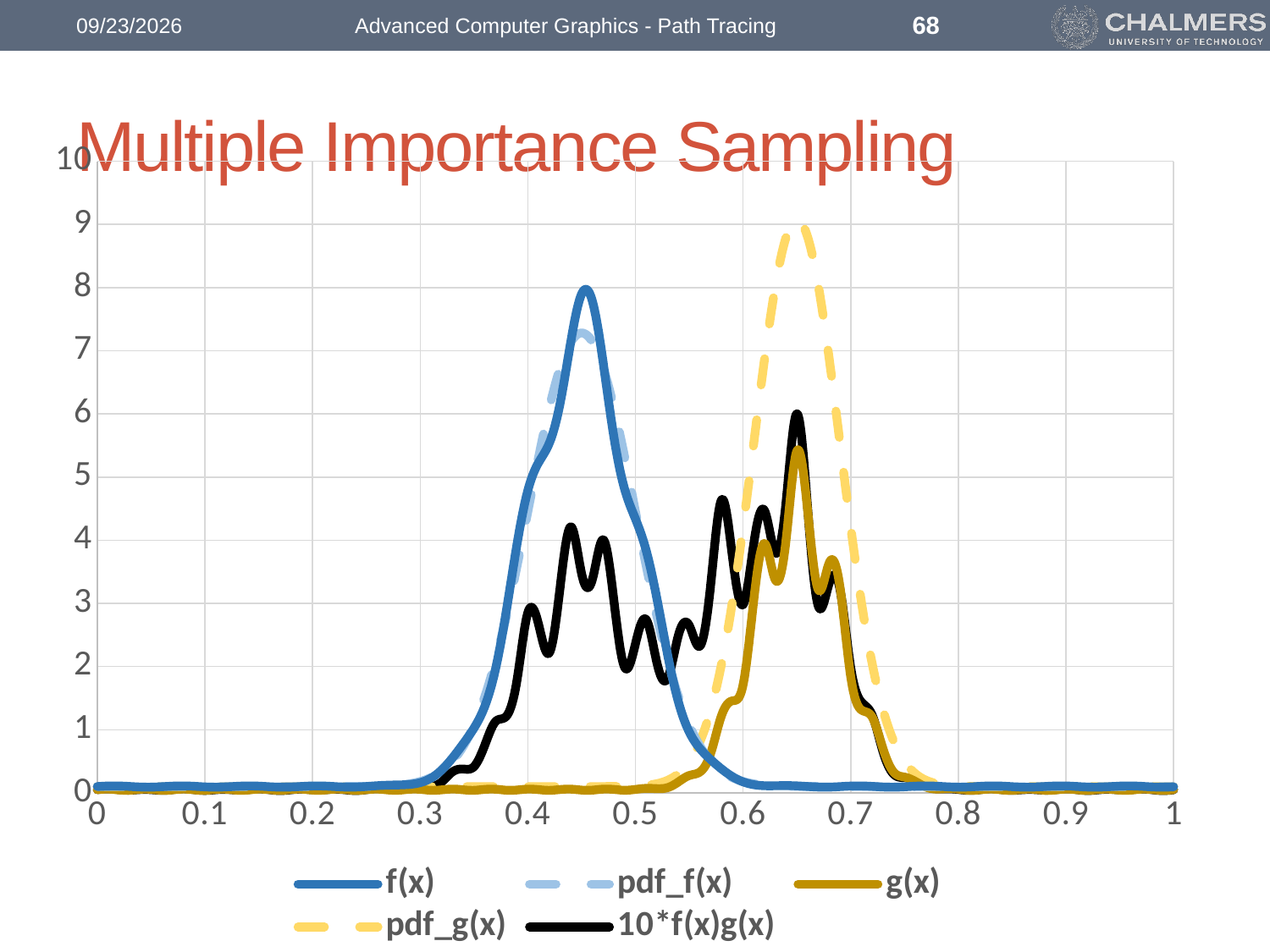
Is the peak value of pdf_g(x) greater or less than 8? greater Is the peak value of f(x) greater or less than 7? greater What is the highest tick value shown on the y axis? 10 Is the peak value of g(x) greater or less than 6? less Which has a higher peak, f(x) or g(x)? f(x) Which has a higher peak, pdf_g(x) or pdf_f(x)? pdf_g(x) What kind of chart is shown on the slide? line chart Which series reaches the highest peak value on the chart? pdf_g(x) Which series is drawn as a black solid line? 10*f(x)g(x) How many series does the legend list? 5